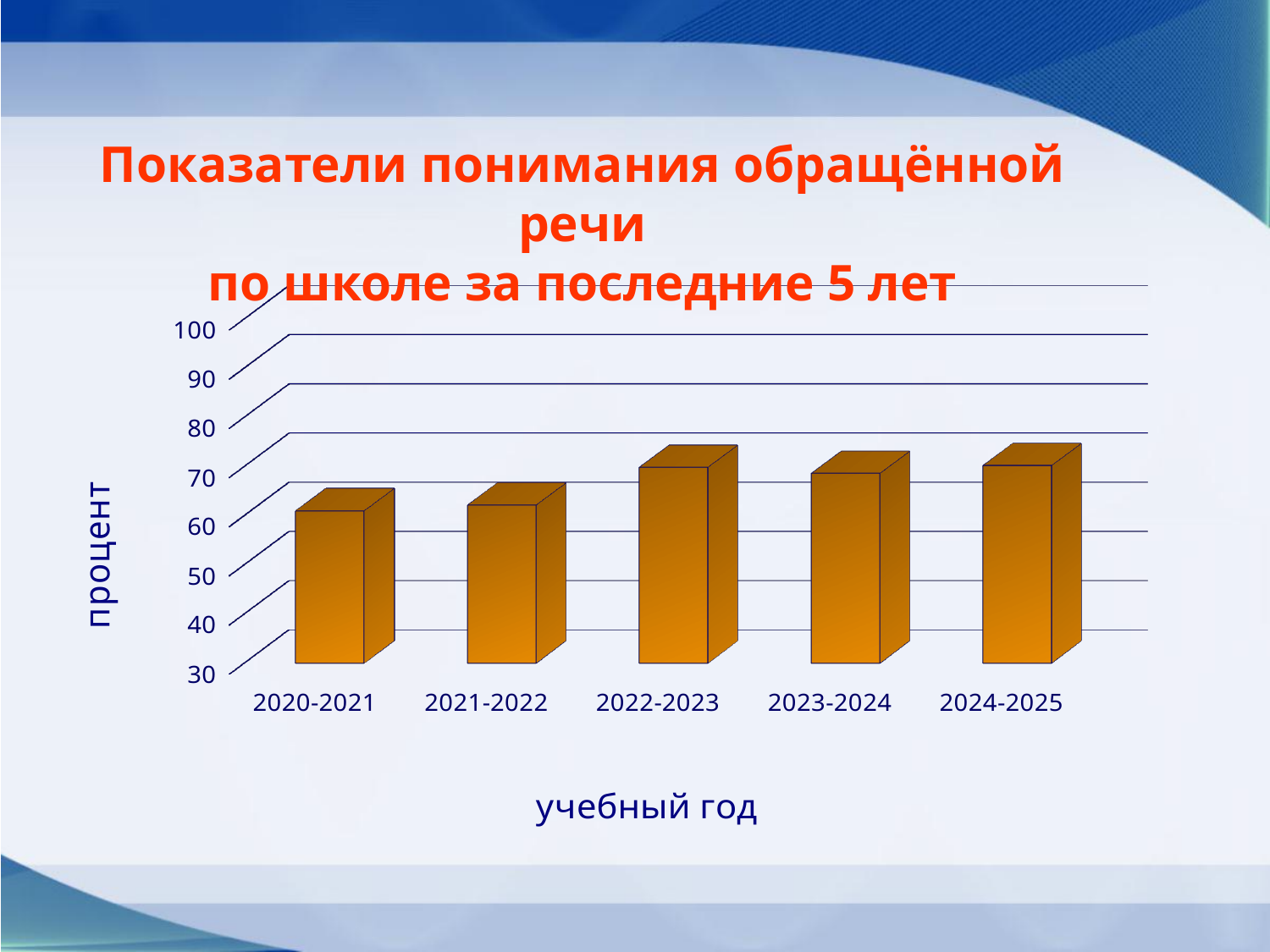
Is the value for 2022-2023 greater or less than 60? greater Is the value for 2020-2021 greater or less than 50? greater How many academic years (categories) are shown on the x axis? 5 Is the value for 2020-2021 greater or less than 70? less Which is larger, the value for 2021-2022 or the value for 2023-2024? 2023-2024 Do the values generally rise or fall from 2020-2021 to 2024-2025? rise Which is larger, the value for 2020-2021 or the value for 2022-2023? 2022-2023 What is the label of the vertical axis? процент What kind of chart is shown on the slide? bar chart